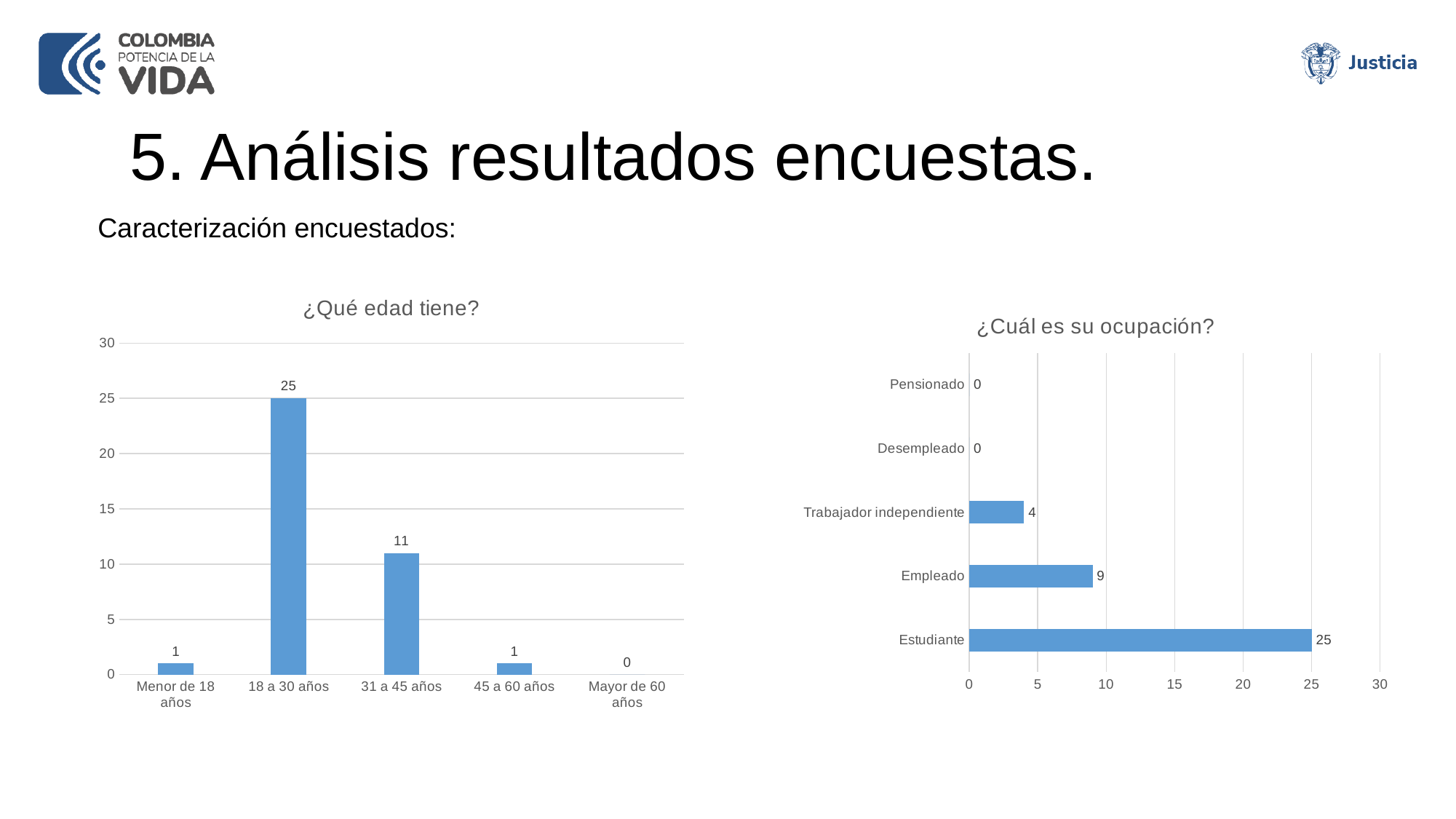
In the '¿Qué edad tiene?' chart, which age category has the highest value? 18 a 30 años In the '¿Cuál es su ocupación?' chart, which occupation has the highest value? Estudiante In the '¿Qué edad tiene?' chart, what is the difference between the values for '18 a 30 años' and '31 a 45 años'? 14 In the '¿Qué edad tiene?' chart, what is the value for '31 a 45 años'? 11 In the '¿Qué edad tiene?' chart, which age category has the lowest value? Mayor de 60 años In the '¿Cuál es su ocupación?' chart, what is the value for 'Trabajador independiente'? 4 In the '¿Cuál es su ocupación?' chart, what is the value for 'Empleado'? 9 In the '¿Cuál es su ocupación?' chart, what is the difference between the values for 'Estudiante' and 'Empleado'? 16 In the '¿Qué edad tiene?' chart, how many age categories are shown? 5 In the '¿Qué edad tiene?' chart, what is the value for '18 a 30 años'? 25 What kind of chart is '¿Cuál es su ocupación?'? Bar chart In the '¿Cuál es su ocupación?' chart, which is larger, the value for 'Empleado' or 'Trabajador independiente'? Empleado